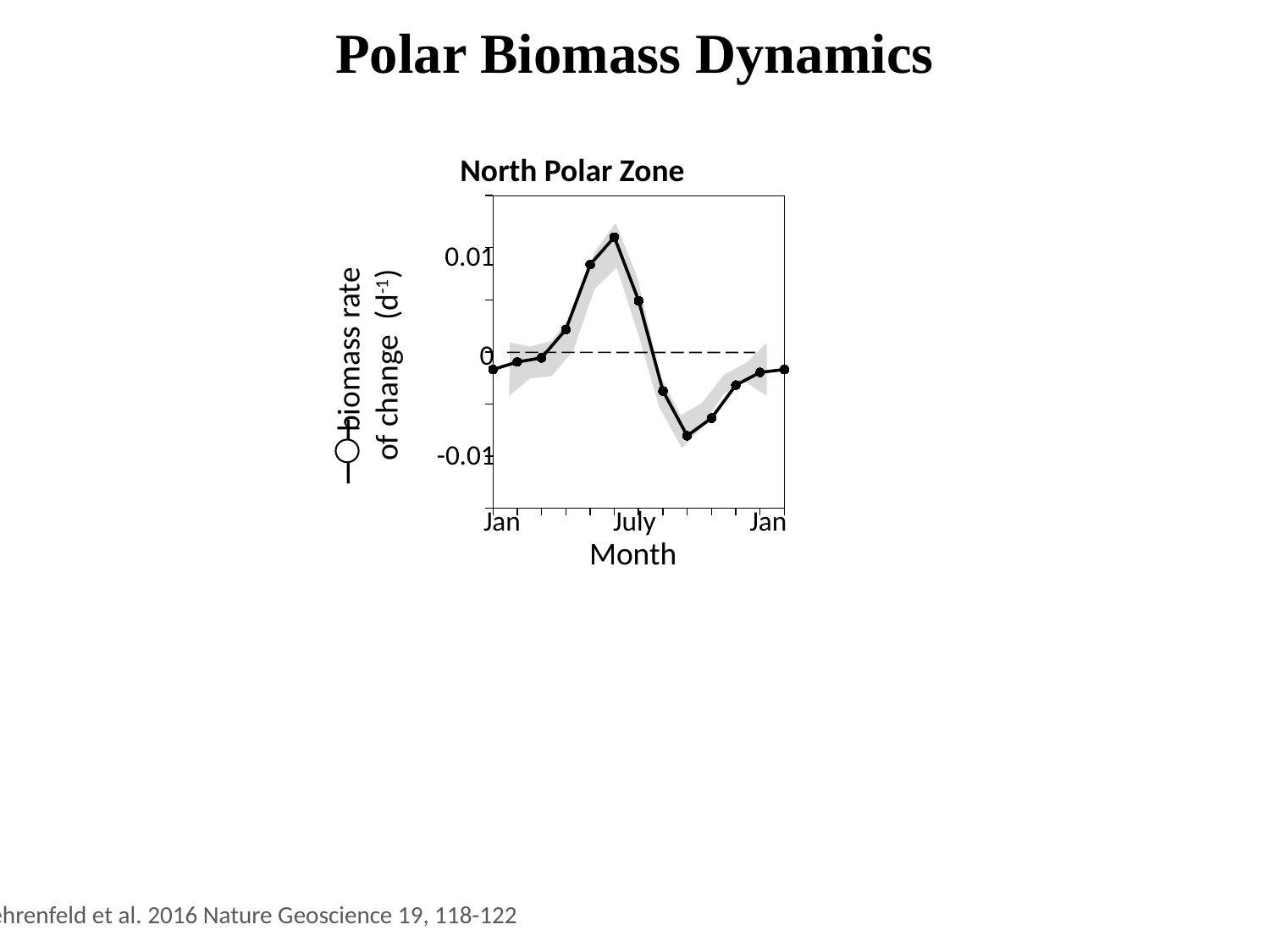
Is the peak value of the biomass rate of change greater or less than 0.01? greater How many data points are plotted on the line? 13 Which is larger, the value at July or the value at the final Jan? July Is the value at July greater or less than 0? greater Is the value at the first Jan greater or less than 0? less What type of chart is shown on the slide? line chart What is the label of the x axis? Month Does the highest point on the line occur before or after the July tick? before Does the biomass rate of change rise or fall from July to the following two months? fall What is the title of the chart? North Polar Zone Does the biomass rate of change rise or fall from Jan to its peak just before July? rise